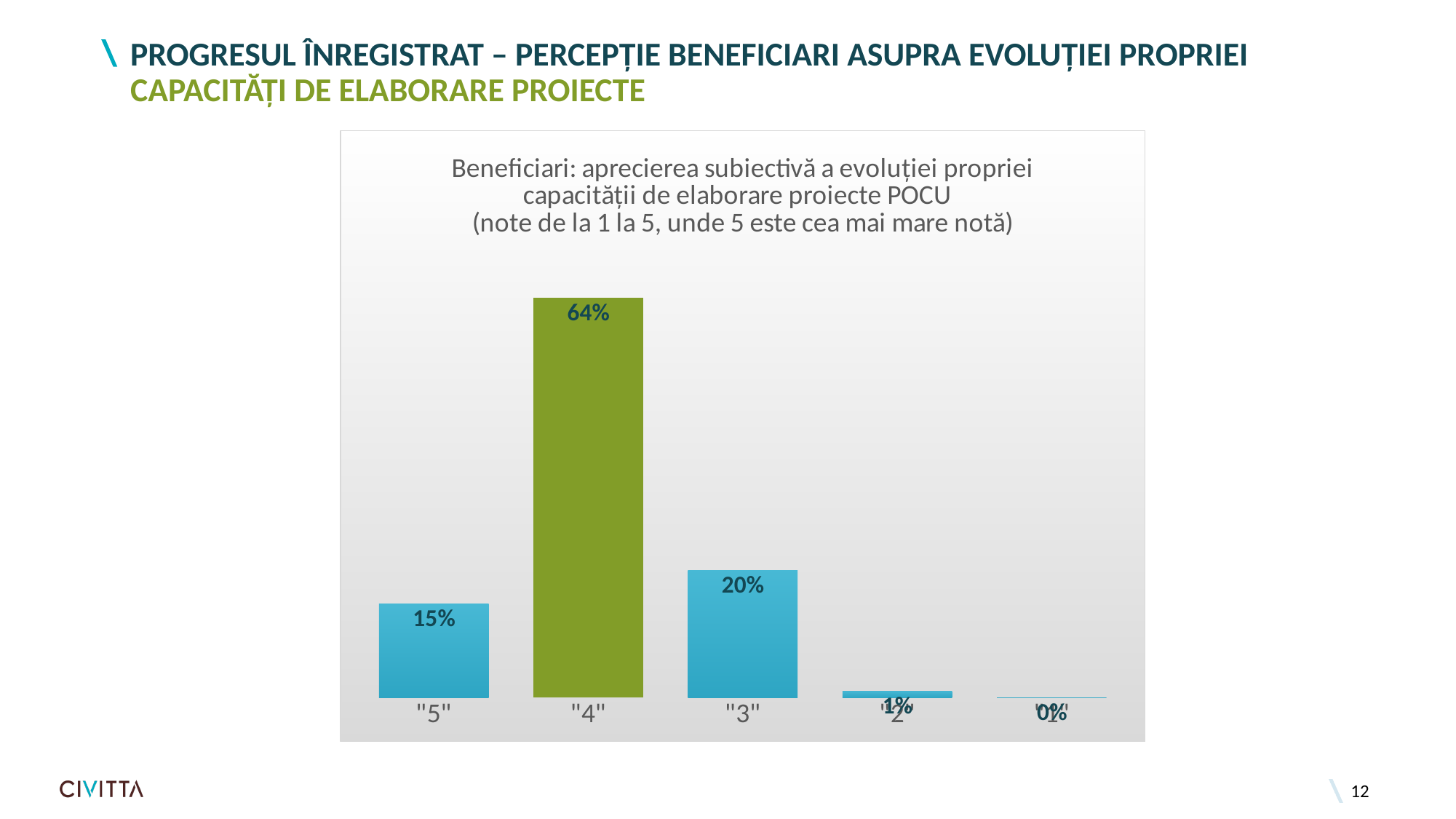
What percentage of beneficiaries gave the rating "5"? 15% What percentage of beneficiaries gave the rating "3"? 20% What type of chart is shown on the slide? Bar chart Which rating received the highest share of beneficiaries? "4" Which rating received the lowest share of beneficiaries? "1" What is the difference between the share for rating "3" and the share for rating "5"? 5% What percentage of beneficiaries gave the rating "4"? 64% What is the difference between the share for rating "4" and the share for rating "3"? 44% Which rating has a larger share, "5" or "3"? "3" How many rating categories are shown on the x axis? 5 What percentage of beneficiaries gave the rating "2"? 1% Which bar is coloured green rather than blue? "4"